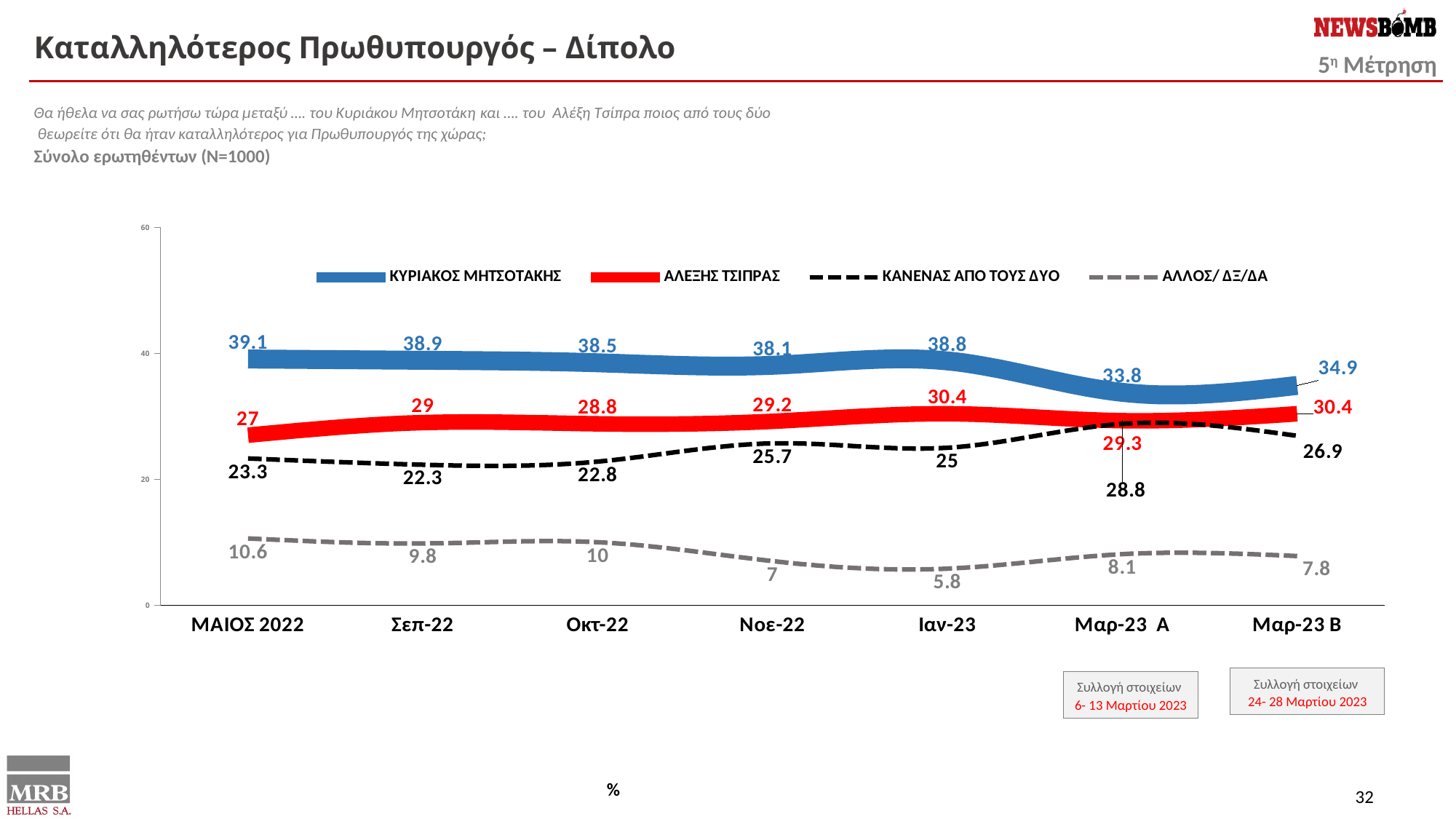
Which is larger for ΚΥΡΙΑΚΟΣ ΜΗΤΣΟΤΑΚΗΣ: the value in Ιαν-23 or in Μαρ-23 Α? Ιαν-23 What is the value for ΑΛΛΟΣ/ ΔΞ/ΔΑ in Ιαν-23? 5.8 What is the value for ΚΑΝΕΝΑΣ ΑΠΟ ΤΟΥΣ ΔΥΟ in Νοε-22? 25.7 How many time periods are shown on the x axis? 7 In which period does ΑΛΛΟΣ/ ΔΞ/ΔΑ have its lowest value? Ιαν-23 What kind of chart is shown on the slide? Line chart What is the difference between ΚΥΡΙΑΚΟΣ ΜΗΤΣΟΤΑΚΗΣ and ΑΛΕΞΗΣ ΤΣΙΠΡΑΣ in Μαρ-23 Β? 4.5 By how much did the value for ΚΥΡΙΑΚΟΣ ΜΗΤΣΟΤΑΚΗΣ fall from Ιαν-23 to Μαρ-23 Α? 5 In which period does ΚΥΡΙΑΚΟΣ ΜΗΤΣΟΤΑΚΗΣ have his highest value? ΜΑΙΟΣ 2022 What is the value for ΚΥΡΙΑΚΟΣ ΜΗΤΣΟΤΑΚΗΣ in ΜΑΙΟΣ 2022? 39.1 How many series does the legend list? 4 What is the value for ΑΛΕΞΗΣ ΤΣΙΠΡΑΣ in Ιαν-23? 30.4